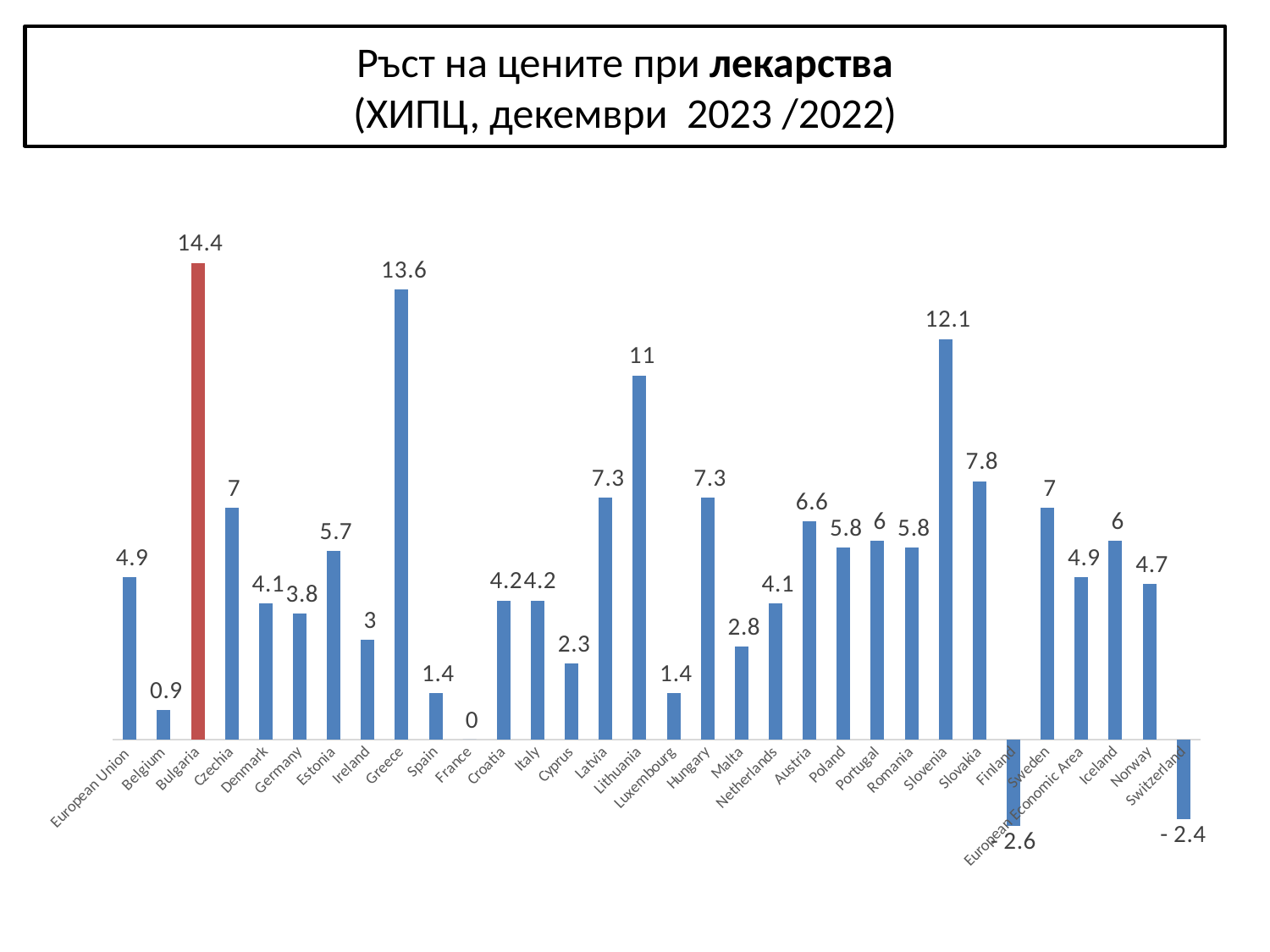
What is the value for Slovenia? 12.1 What is the difference between the values for Bulgaria and Greece? 0.8 What is the value for France? 0 Which country's bar is coloured red instead of blue? Bulgaria What is the value for Switzerland? -2.4 Which country has the highest value? Bulgaria What is the value for Greece? 13.6 What is the value for Bulgaria? 14.4 Which has a larger value, Slovenia or Lithuania? Slovenia Which has a larger value, Austria or Poland? Austria How many categories are shown on the x axis? 32 What kind of chart is shown on the slide? Bar chart